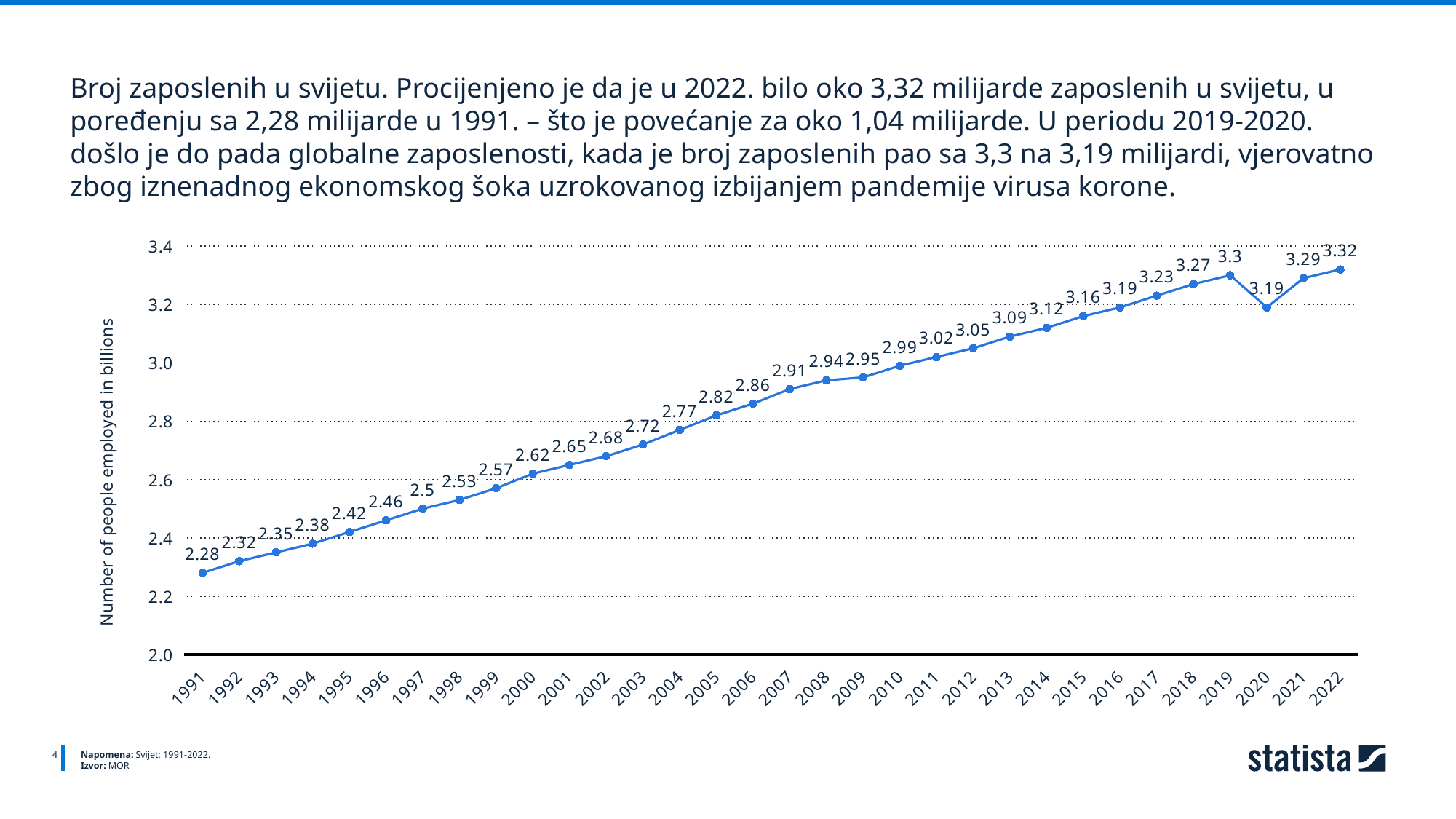
How many years are plotted on the chart? 32 Which year has the highest number of people employed? 2022 What type of chart is shown on the slide? line chart What is the difference between the values for 2019 and 2020? 0.11 What is the number of people employed in billions in 2020? 3.19 Which year has the lowest number of people employed? 1991 Does the number of people employed generally rise or fall from 1991 to 2022? rise What is the number of people employed in billions in 1991? 2.28 What is the number of people employed in billions in 2007? 2.91 What is the difference between the values for 2022 and 1991? 1.04 What is the label of the vertical axis? Number of people employed in billions Which year has a larger value, 2019 or 2021? 2019